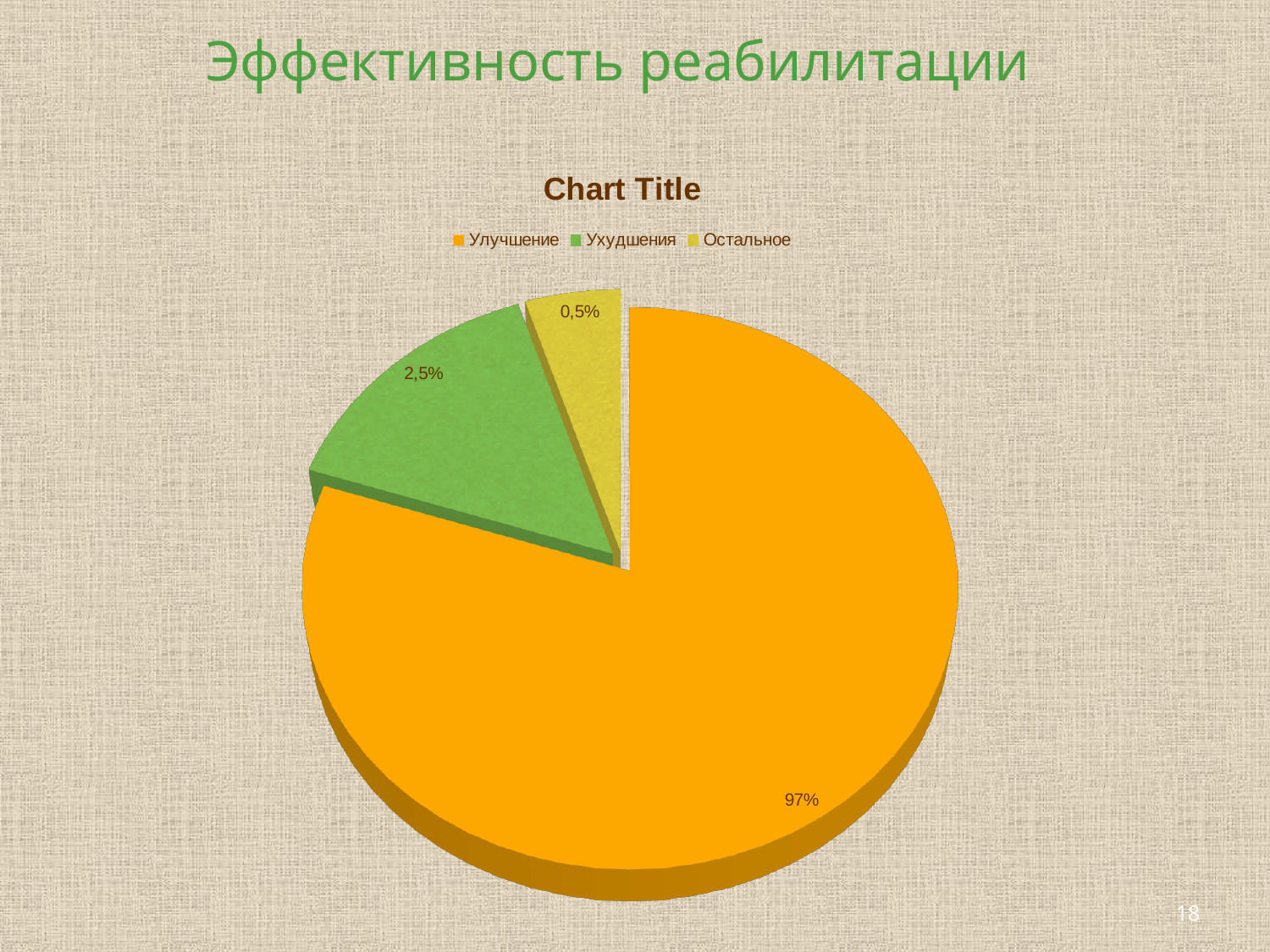
What colour is the slice for Улучшение? orange What is the value shown for Остальное? 0,5% What is the title printed above the chart? Chart Title How many slices does the pie chart have? 3 What kind of chart is shown on the slide? pie chart Which category has the largest slice of the pie? Улучшение Which is larger, the slice for Ухудшения or the slice for Остальное? Ухудшения What is the value shown for Ухудшения? 2,5% What is the value shown for Улучшение? 97% Which category has the smallest slice of the pie? Остальное What is the difference between the values for Улучшение and Ухудшения? 94,5% How many entries does the legend list? 3